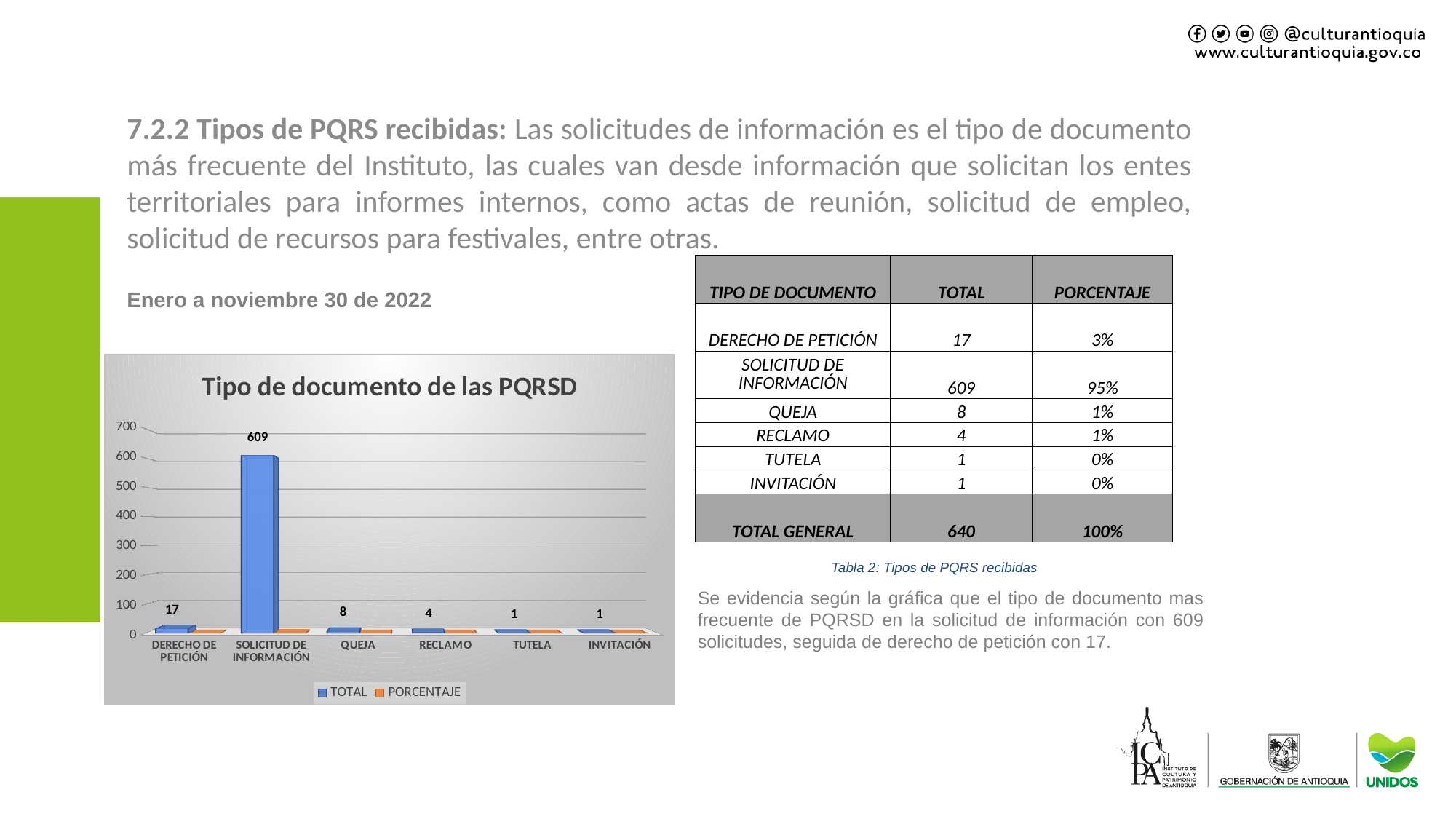
How many document type categories are shown on the x axis of the chart? 6 What is the title of the chart? Tipo de documento de las PQRSD What is the TOTAL value for DERECHO DE PETICIÓN in the chart? 17 What is the TOTAL value for RECLAMO in the chart? 4 How many series does the chart legend list? 2 What kind of chart is shown on the slide? Bar chart Is the TOTAL value for SOLICITUD DE INFORMACIÓN greater or less than 500? greater What is the TOTAL value for QUEJA in the chart? 8 Which has a larger TOTAL, QUEJA or RECLAMO? QUEJA Which category has the highest TOTAL in the chart? SOLICITUD DE INFORMACIÓN What is the difference between the TOTAL for SOLICITUD DE INFORMACIÓN and the TOTAL for DERECHO DE PETICIÓN? 592 What is the TOTAL value for SOLICITUD DE INFORMACIÓN in the chart? 609